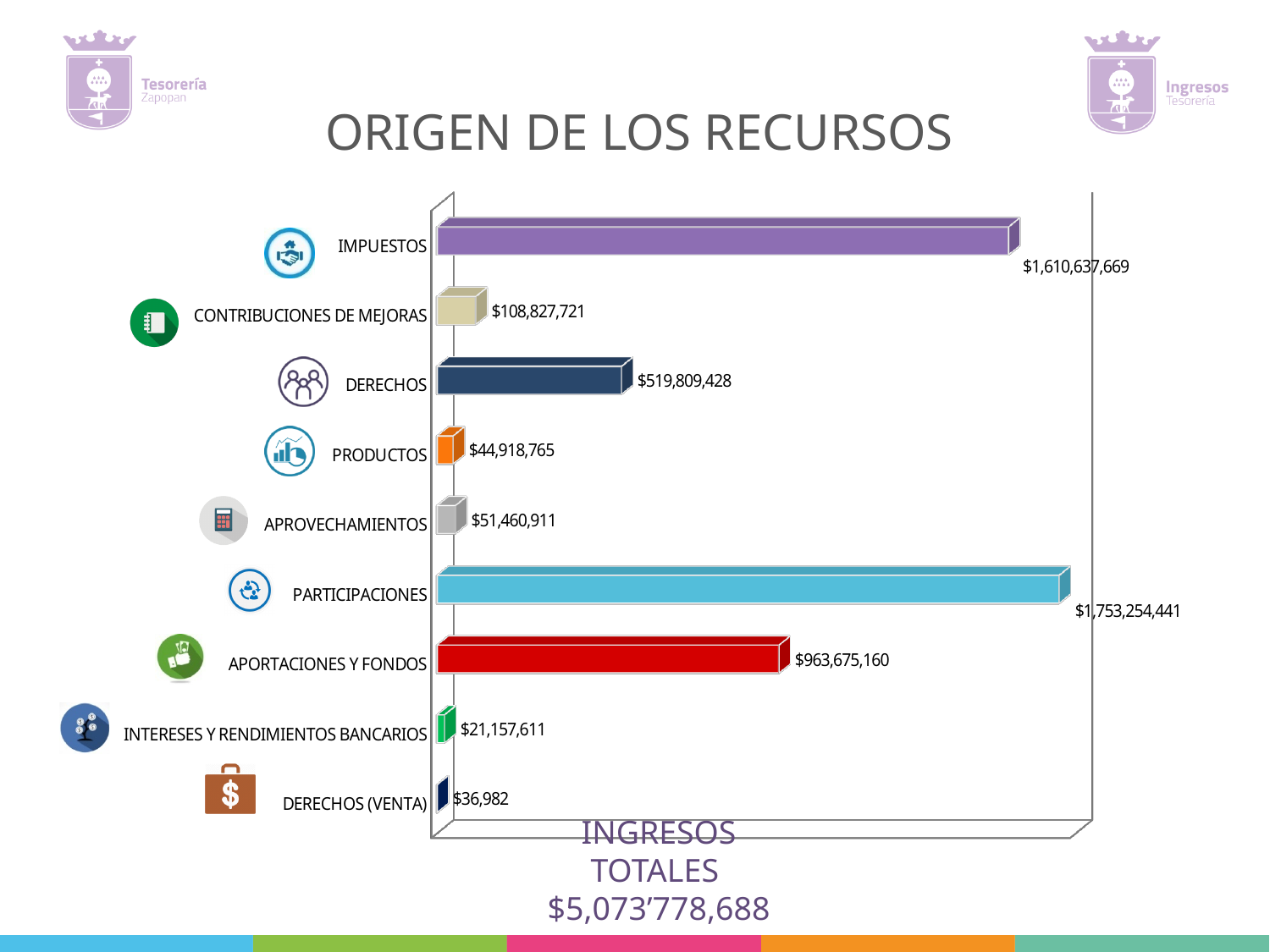
Which category has the lowest value? DERECHOS (VENTA) What kind of chart is shown on the slide? Bar chart What is the value for APORTACIONES Y FONDOS? $963,675,160 What is the value for DERECHOS (VENTA)? $36,982 What is the value for IMPUESTOS? $1,610,637,669 What is the value for INTERESES Y RENDIMIENTOS BANCARIOS? $21,157,611 Which is larger, APROVECHAMIENTOS or PRODUCTOS? APROVECHAMIENTOS What is the value for PARTICIPACIONES? $1,753,254,441 What is the difference between DERECHOS and CONTRIBUCIONES DE MEJORAS? $410,981,707 What is the difference between PARTICIPACIONES and IMPUESTOS? $142,616,772 Which category has the highest value? PARTICIPACIONES How many categories are shown in the chart? 9